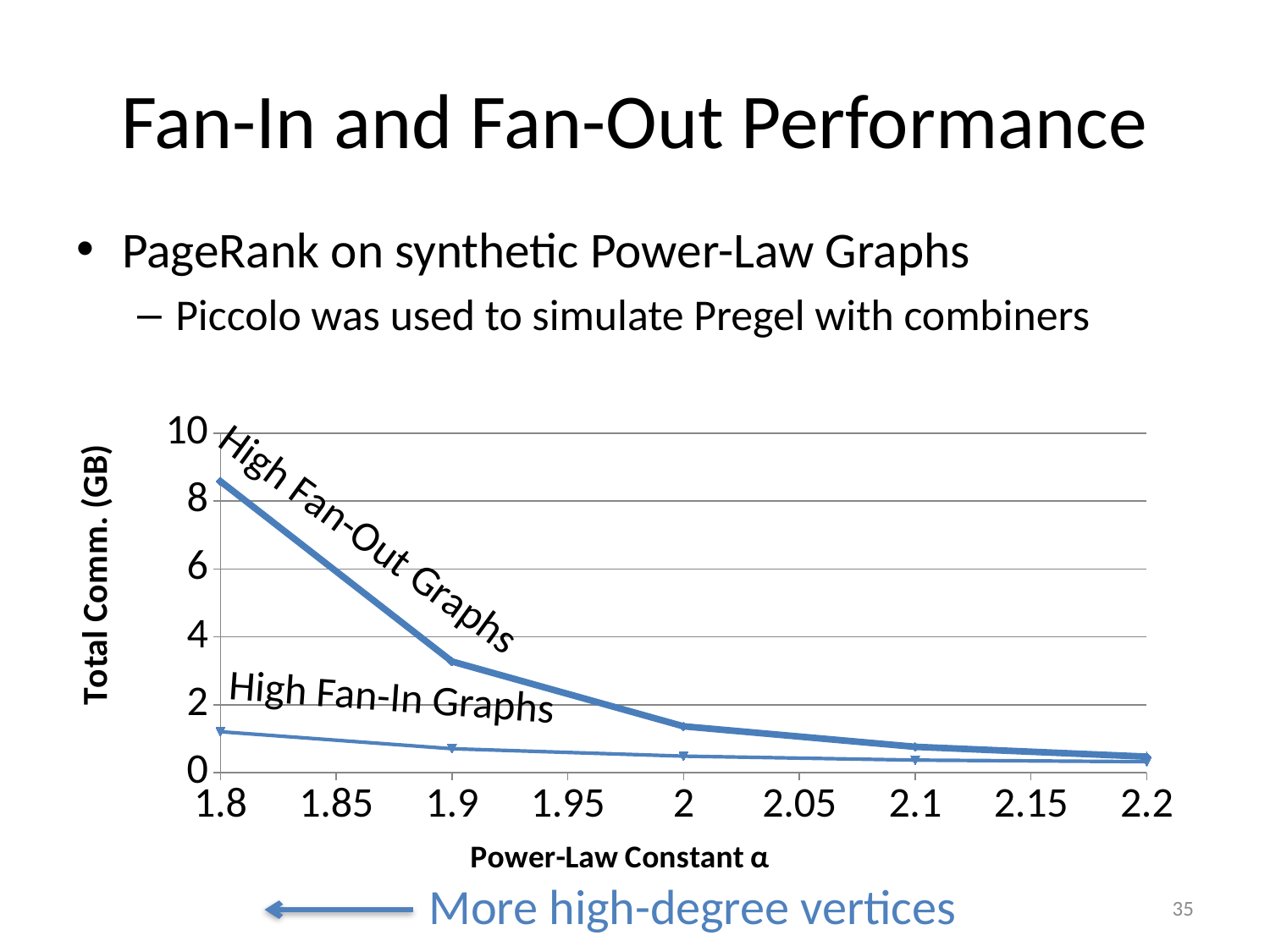
Is the Total Comm. for High Fan-Out Graphs at α = 1.9 greater or less than 4 GB? less At which value of α does the High Fan-Out Graphs series reach its highest Total Comm.? 1.8 What kind of chart is shown on the slide? line chart Is the Total Comm. for High Fan-Out Graphs at α = 1.8 greater or less than 8 GB? greater Is the Total Comm. for High Fan-In Graphs at α = 1.8 greater or less than 2 GB? less At α = 1.8, which series has the higher Total Comm.: High Fan-Out Graphs or High Fan-In Graphs? High Fan-Out Graphs How many data series are plotted in the chart? 2 How many data points are plotted for the High Fan-Out Graphs series? 5 Does the Total Comm. for High Fan-Out Graphs rise or fall as the Power-Law Constant α increases? fall Does the Total Comm. for High Fan-In Graphs rise or fall as the Power-Law Constant α increases? fall What are the names of the two series plotted in the chart? High Fan-Out Graphs and High Fan-In Graphs What is the title of the x axis of the chart? Power-Law Constant α